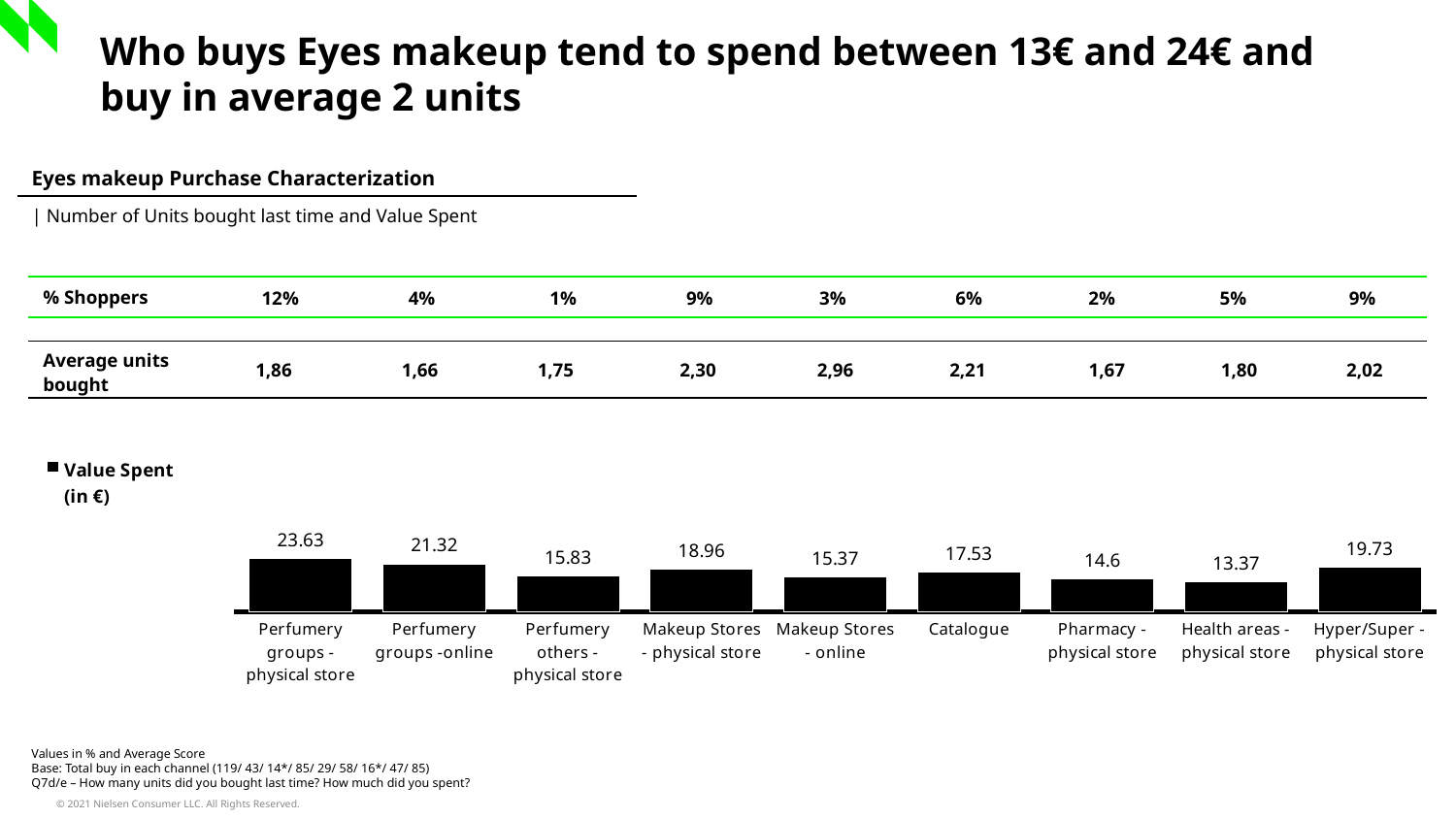
What is the difference in Value Spent (in €) between Makeup Stores - physical store and Makeup Stores - online? 3.59 Which has a higher Value Spent (in €): Catalogue or Perfumery others - physical store? Catalogue What is the difference in Value Spent (in €) between Perfumery groups - physical store and Health areas - physical store? 10.26 What is the Value Spent (in €) for Catalogue? 17.53 How many channels are shown in the Value Spent chart? 9 How many series does the legend of the Value Spent chart list? 1 Which channel has the highest Value Spent (in €)? Perfumery groups - physical store What is the Value Spent (in €) for Makeup Stores - online? 15.37 Which has a higher Value Spent (in €): Perfumery groups - online or Hyper/Super - physical store? Perfumery groups - online What type of chart is used to show Value Spent (in €)? Bar chart What is the Value Spent (in €) for Pharmacy - physical store? 14.6 Which channel has the lowest Value Spent (in €)? Health areas - physical store